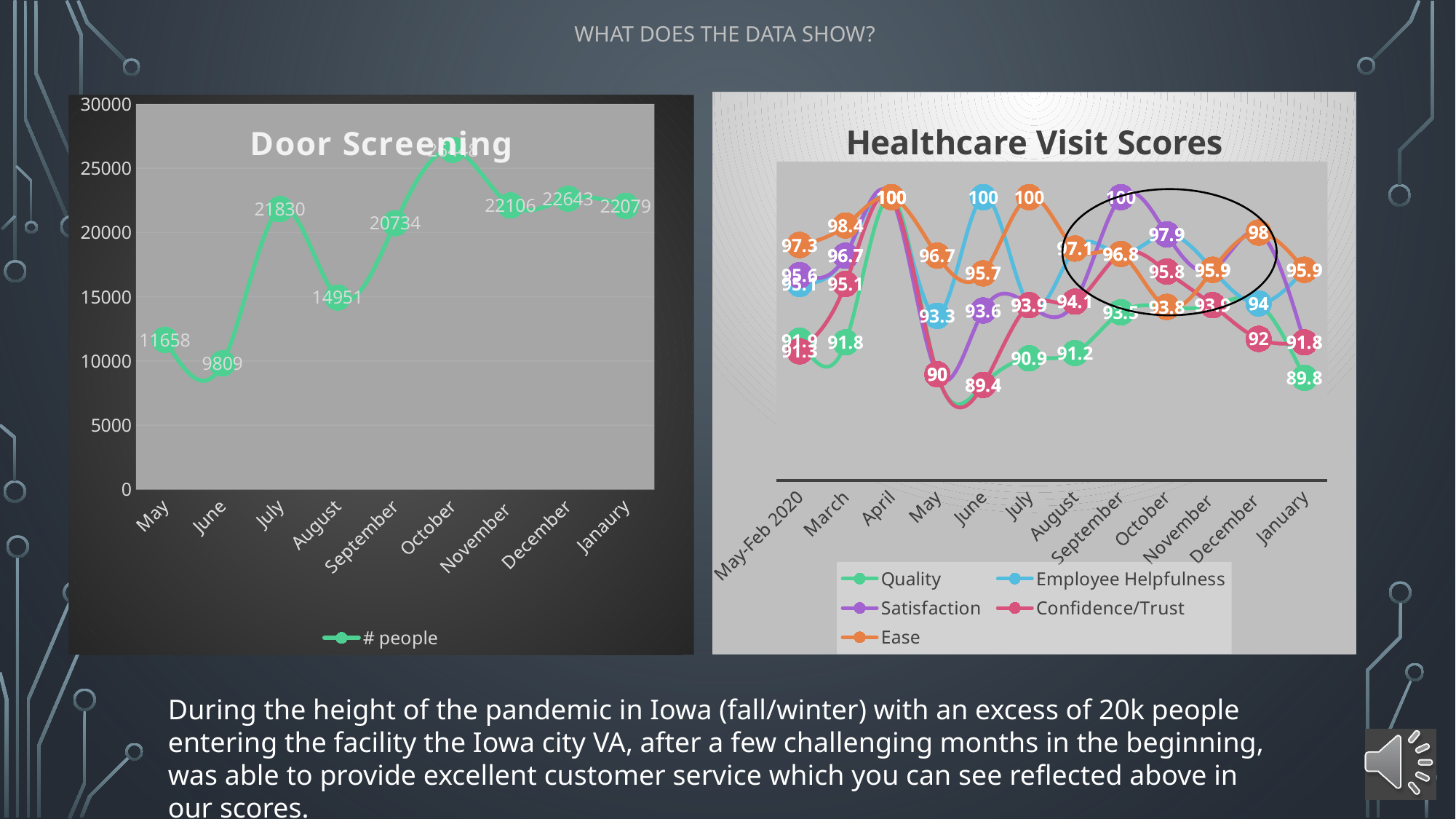
In the Healthcare Visit Scores chart, what is the Quality score for January? 89.8 In the Healthcare Visit Scores chart, what is the Ease score for March? 98.4 How many months are plotted in the Door Screening chart? 9 How many series does the legend of the Healthcare Visit Scores chart list? 5 In the Door Screening chart, which month has the lowest number of people? June In the Healthcare Visit Scores chart, what is the Confidence/Trust score for June? 89.4 In the Door Screening chart, which month has the highest number of people? October In the Door Screening chart, what is the difference between the December and November values? 537 In the Door Screening chart, how many people were screened in July? 21830 In the Door Screening chart, is the value for October greater or less than 25000? greater What type of chart is the Door Screening chart? line chart In the Door Screening chart, which is larger, the value for August or the value for September? September